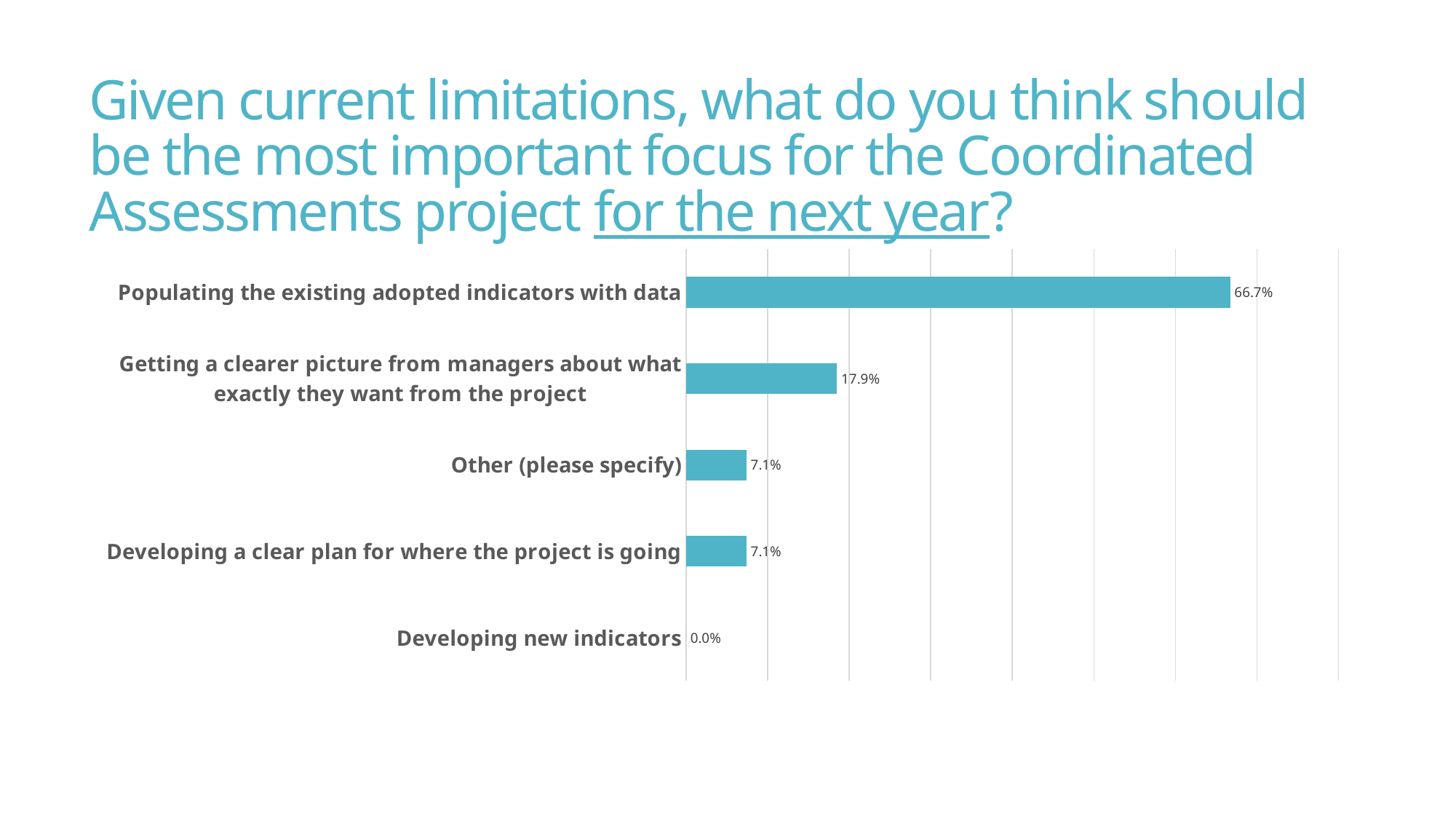
What colour are the bars in the chart? Teal/blue Which category has the lowest value? Developing new indicators What is the value for 'Other (please specify)'? 7.1% What percentage of respondents chose 'Populating the existing adopted indicators with data'? 66.7% Which is larger: the value for 'Getting a clearer picture from managers about what exactly they want from the project' or the value for 'Developing a clear plan for where the project is going'? Getting a clearer picture from managers about what exactly they want from the project What is the difference between the values for 'Populating the existing adopted indicators with data' and 'Getting a clearer picture from managers about what exactly they want from the project'? 48.8% What kind of chart is shown on the slide? Bar chart How many categories are shown in the chart? 5 What is the value for 'Developing new indicators'? 0.0% What is the difference between the values for 'Getting a clearer picture from managers about what exactly they want from the project' and 'Other (please specify)'? 10.8% Which category has the highest value? Populating the existing adopted indicators with data What is the value for 'Getting a clearer picture from managers about what exactly they want from the project'? 17.9%